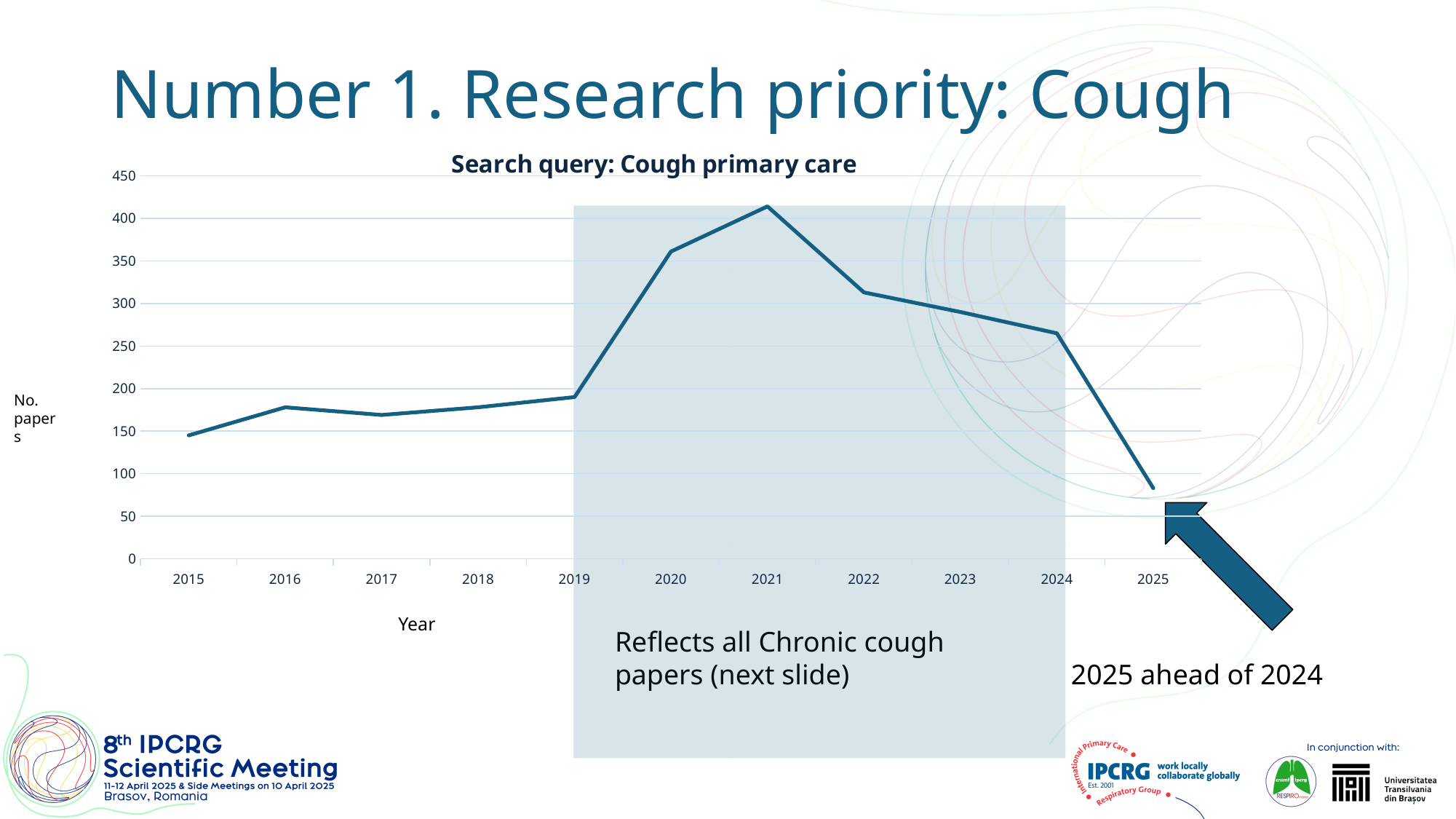
Is the value for 2025 greater or less than 100? less Is the value for 2024 greater or less than 250? greater What is the title of the chart? Search query: Cough primary care How many years are plotted along the x axis of the chart? 11 Is the value for 2015 greater or less than 200? less Which year has the highest number of papers? 2021 Which year has more papers, 2020 or 2024? 2020 Which year has the lowest number of papers? 2025 Do the values rise or fall from 2021 to 2025? fall What label is shown on the x axis of the chart? Year What kind of chart is shown on the slide? line chart